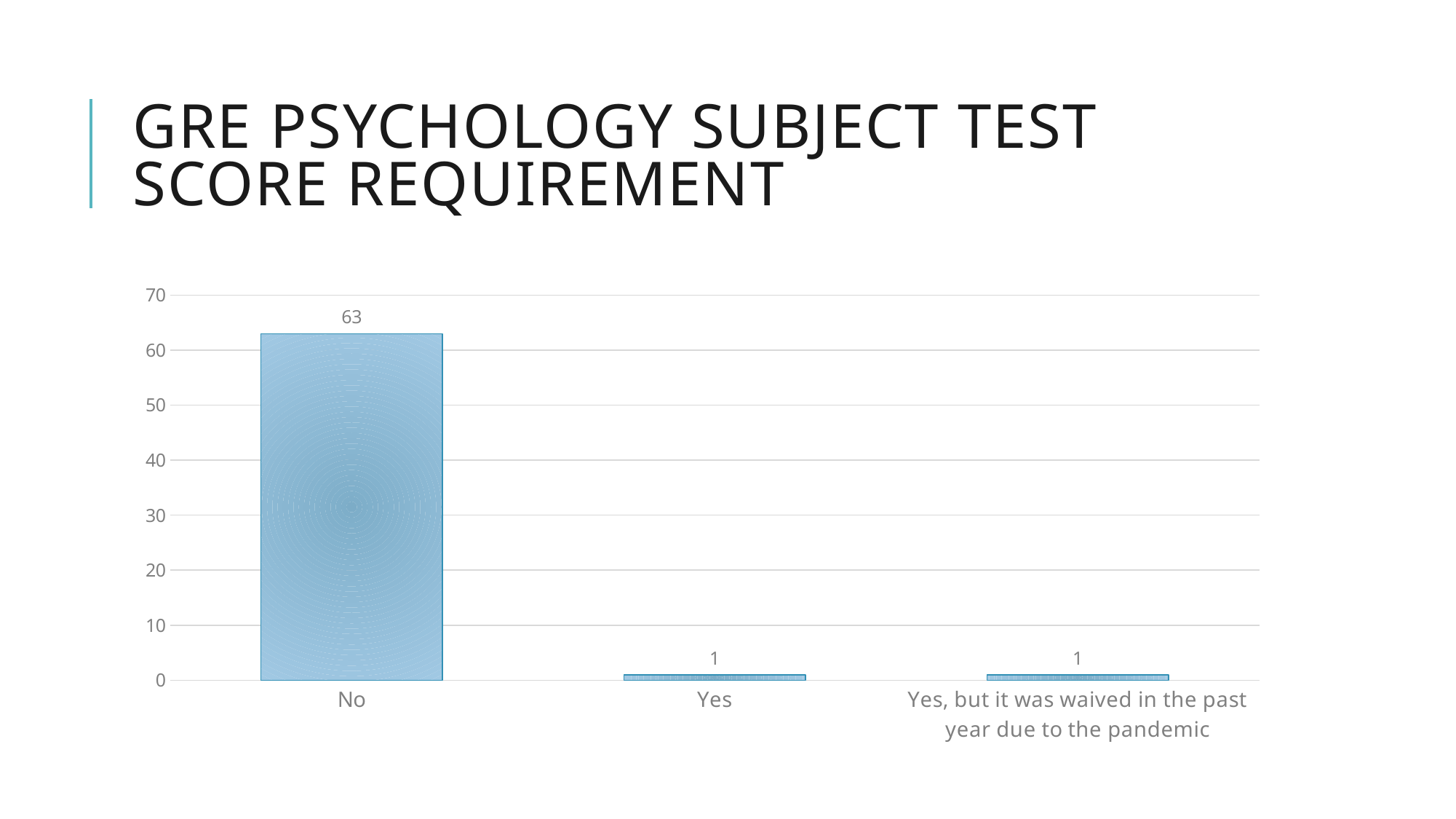
Which is larger, the value for "No" or the value for "Yes"? No What is the difference between the values for "No" and "Yes"? 62 Is the value for "No" greater or less than 60? greater Is the value for "Yes" greater or less than 10? less What is the value for the "Yes" category? 1 What kind of chart is shown on the slide? bar chart What is the total of the three values shown in the chart? 65 What is the value for "Yes, but it was waived in the past year due to the pandemic"? 1 How many categories are shown on the x axis? 3 What is the value for the "No" category? 63 Which category has the highest value? No What is the title of the slide? GRE Psychology Subject Test Score Requirement